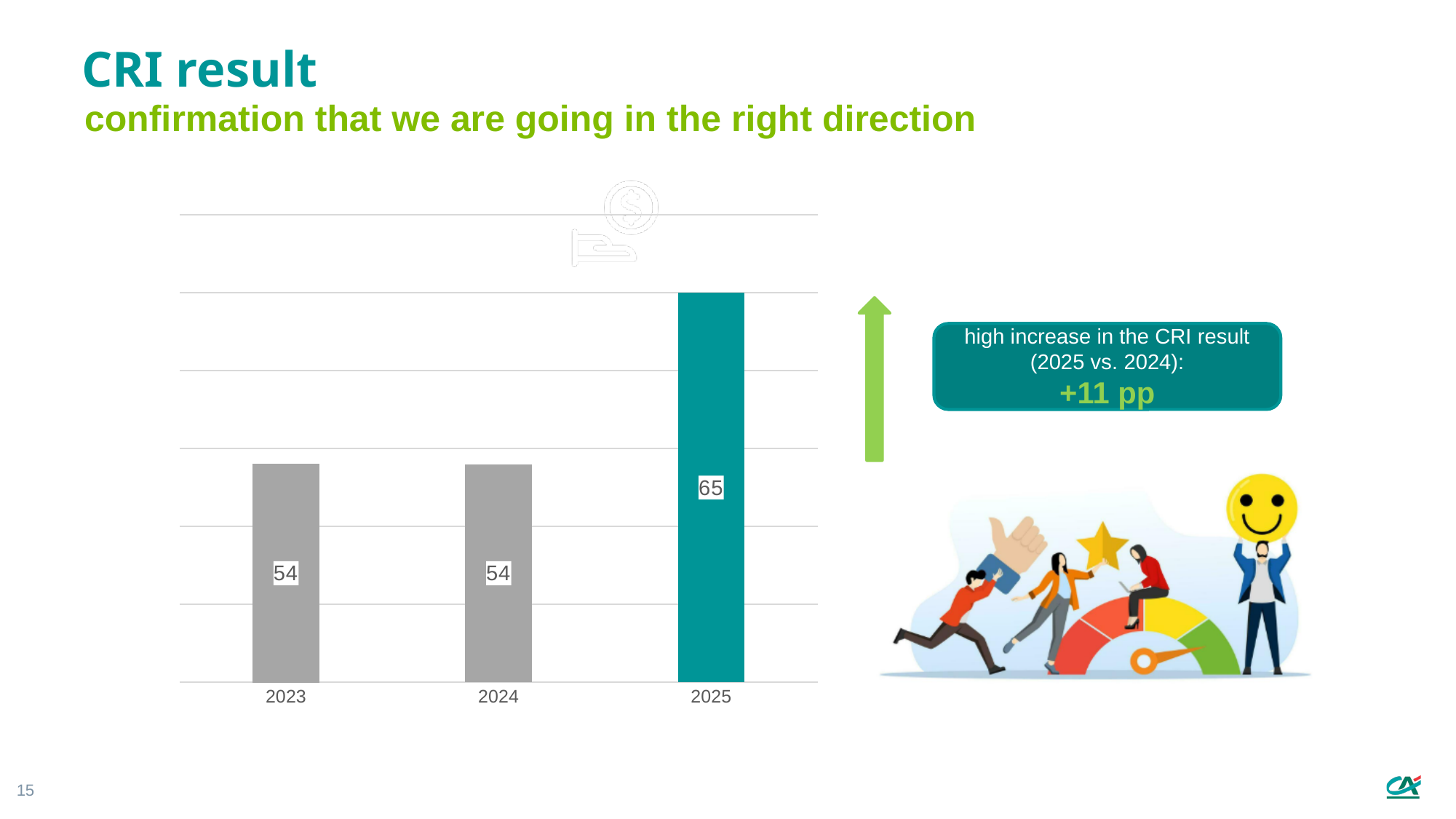
What colour is the bar for 2025? Teal Do the CRI results rise or fall from 2024 to 2025? Rise How many years are shown on the x axis of the chart? 3 What increase in the CRI result (2025 vs. 2024) is stated in the callout box next to the chart? +11 pp Which year has the highest CRI result? 2025 What is the CRI result for 2023? 54 What kind of chart is shown on the slide? Bar chart What is the difference between the CRI result for 2025 and 2024? 11 What is the CRI result for 2025? 65 What is the CRI result for 2024? 54 Are the CRI results for 2023 and 2024 the same or different? The same Is the CRI result for 2025 larger than the CRI result for 2023? Yes